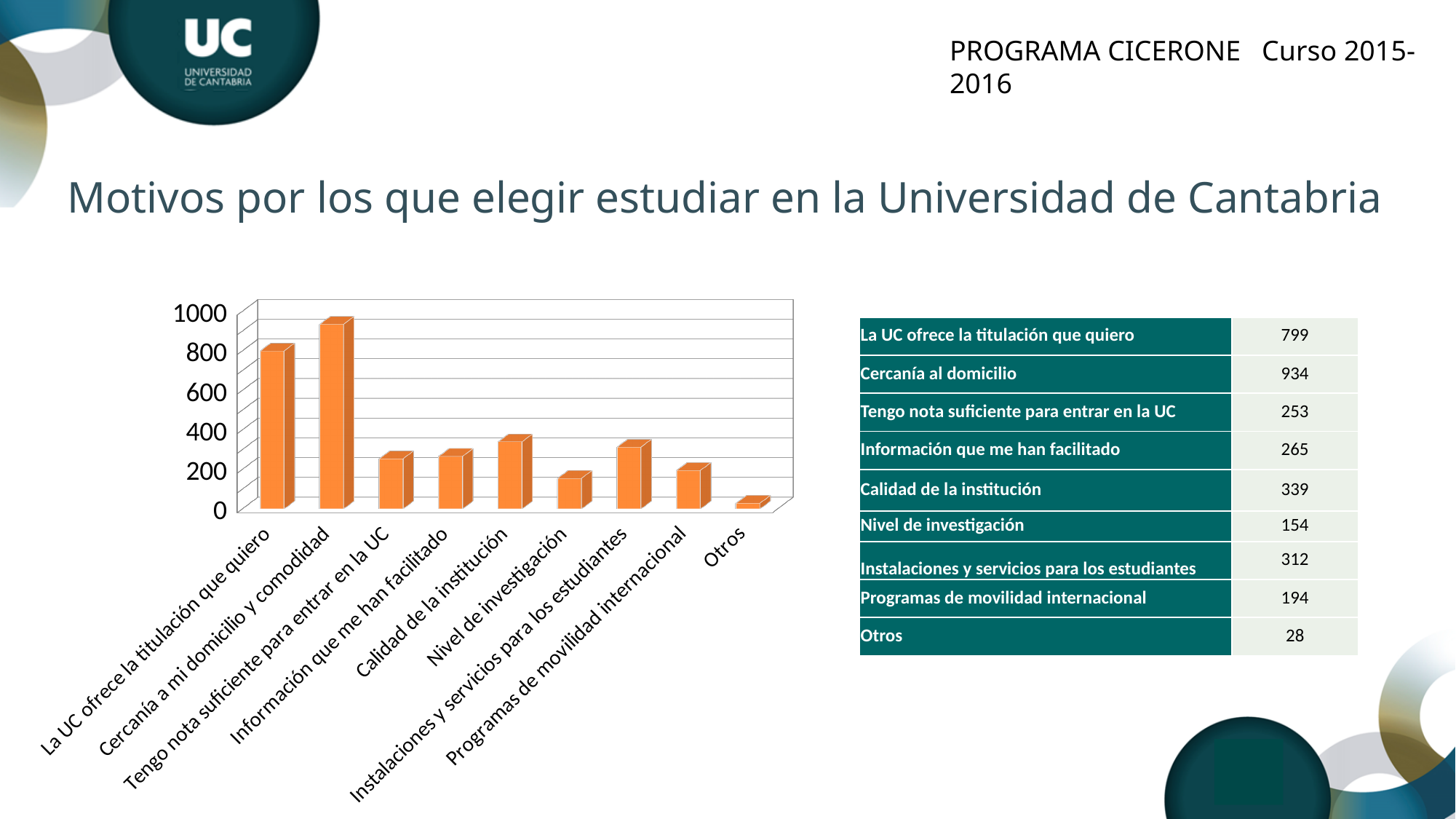
Is the value for 'La UC ofrece la titulación que quiero' greater or less than 600? greater According to the table on the slide, what is the value for 'Otros'? 28 According to the table on the slide, what is the value for 'Calidad de la institución'? 339 How many categories (bars) does the chart show? 9 What kind of chart is shown on the slide? bar chart Which category has the lowest bar in the chart? Otros Is the value for 'Nivel de investigación' greater or less than 200? less What is the title of the slide above the chart? Motivos por los que elegir estudiar en la Universidad de Cantabria Which category has the highest bar in the chart? Cercanía a mi domicilio y comodidad Which is larger, the bar for 'Calidad de la institución' or the bar for 'Nivel de investigación'? Calidad de la institución According to the table on the slide, what is the value for 'Cercanía al domicilio'? 934 Using the values in the table, what is the difference between 'Cercanía al domicilio' and 'La UC ofrece la titulación que quiero'? 135